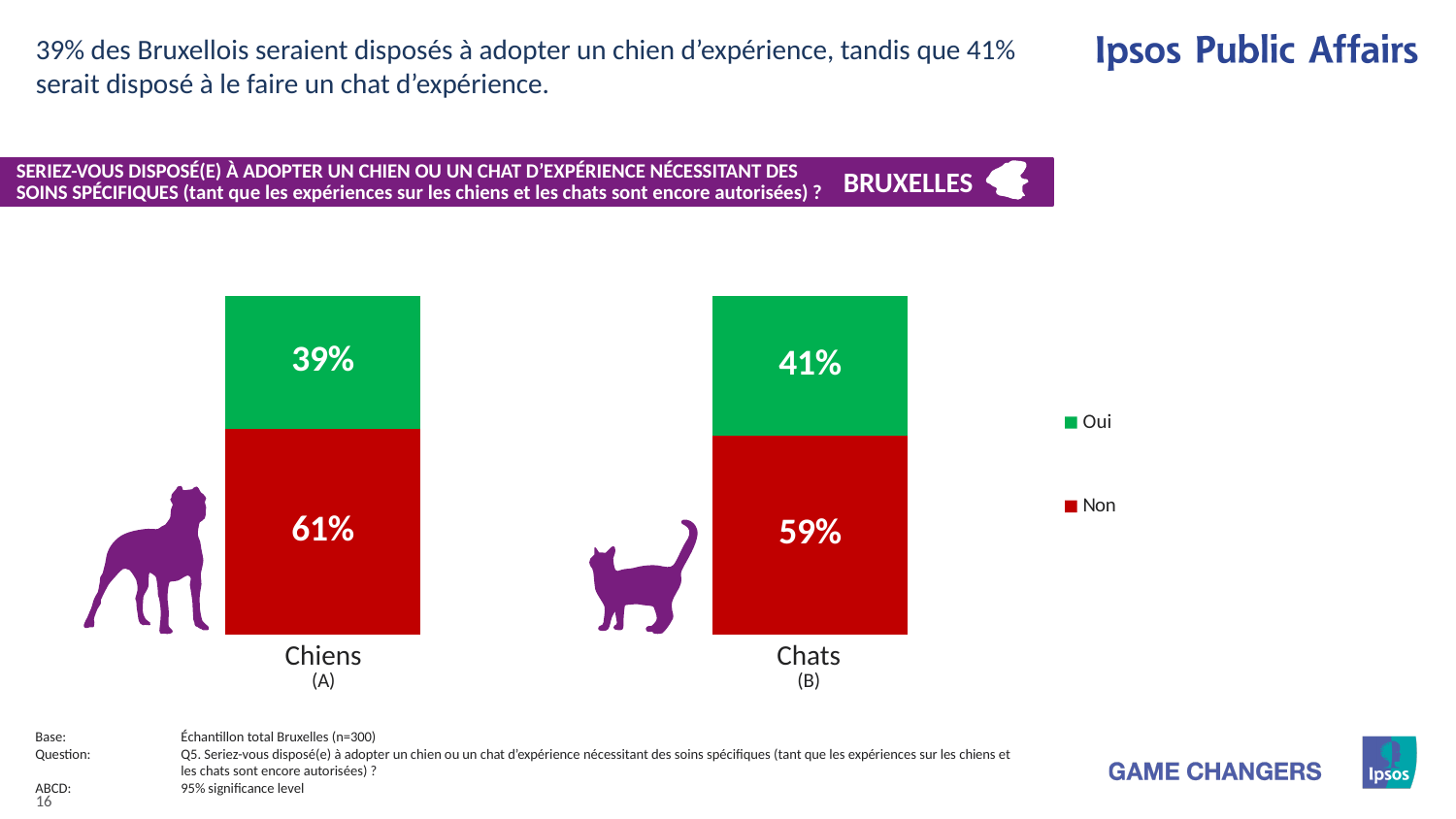
What kind of chart is shown on the slide? Stacked bar chart How many series does the legend list? 2 What is the "Oui" value for Chats? 41% What is the difference between the "Non" values for Chiens and Chats? 2% Which category has the highest "Non" value? Chiens What percentage of respondents answered "Oui" for Chiens? 39% What is the total of the stacked bar for Chiens? 100% How many categories are shown on the x axis? 2 Which category has the higher "Oui" share, Chiens or Chats? Chats What is the "Non" value for Chiens? 61% What percentage of respondents answered "Non" for Chats? 59% Which colour represents "Non" in the legend? Red